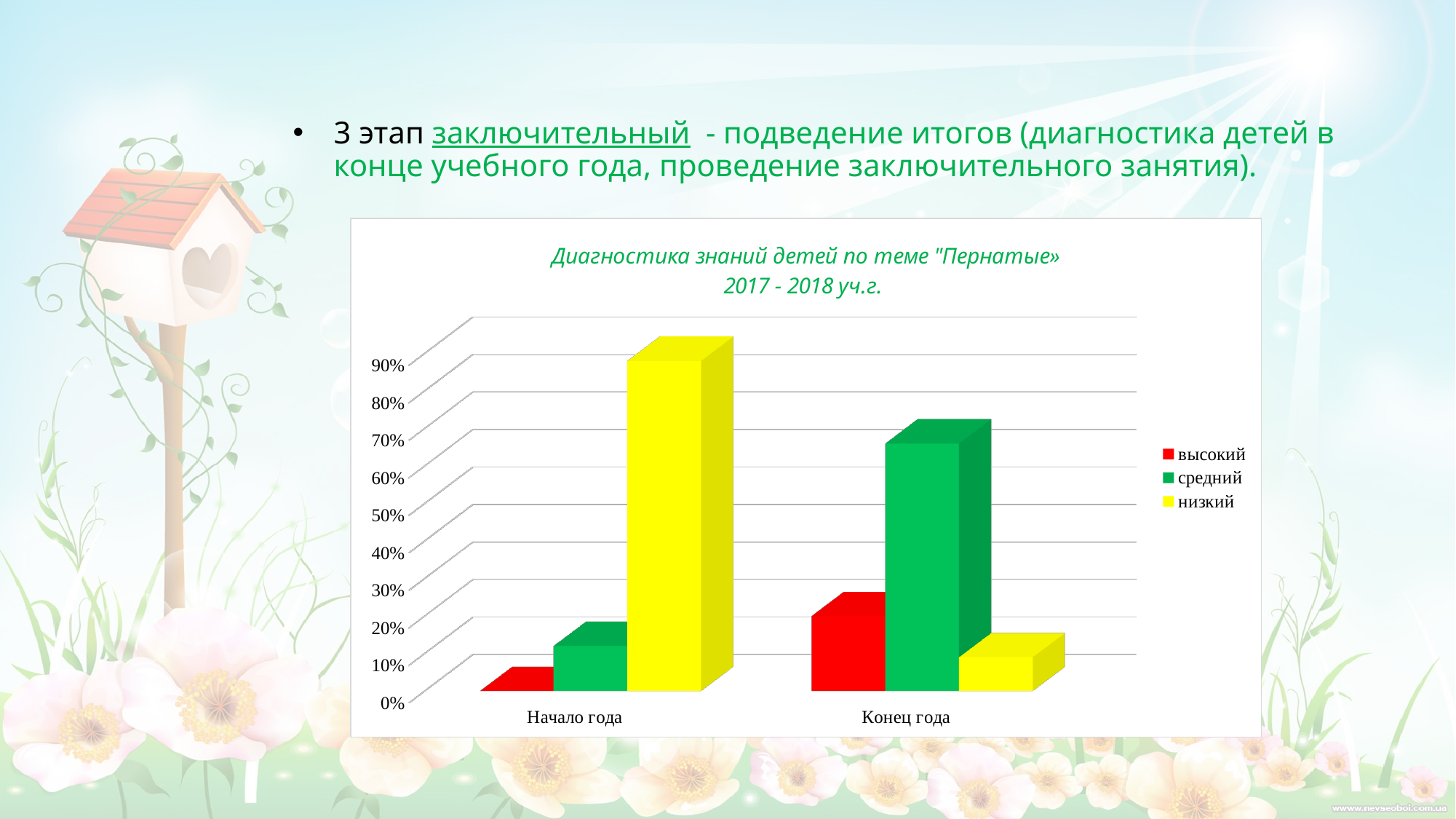
Is the value for высокий at Начало года greater or less than 10%? less Which series has the lowest value for Начало года? высокий Which colour represents the series высокий in the chart legend? red What kind of chart is shown on the slide? bar chart Which series has the lowest value for Конец года? низкий Is the value for средний at Конец года greater or less than 60%? greater Which series has the highest value for Начало года? низкий Does the value for низкий rise or fall from Начало года to Конец года? fall How many series does the chart legend list? 3 Is the value for низкий at Начало года greater or less than 80%? greater How many categories are shown on the x axis of the chart? 2 Which series has the highest value for Конец года? средний